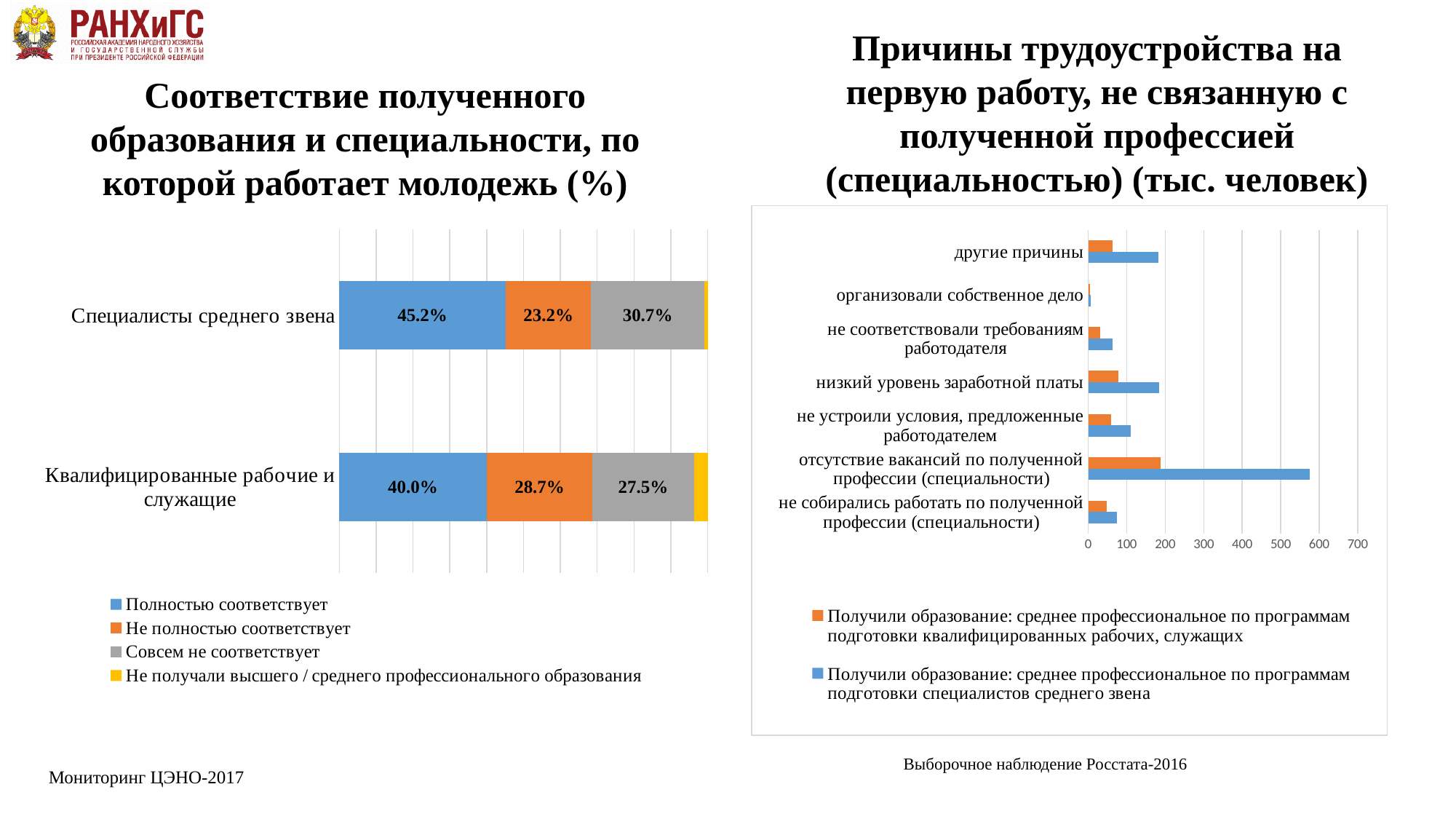
In the left chart (Соответствие полученного образования и специальности), what is the value of 'Полностью соответствует' for 'Специалисты среднего звена'? 45.2% In the right chart, which reason has the highest value for the blue series (специалисты среднего звена)? отсутствие вакансий по полученной профессии (специальности) How many reasons (categories) are listed in the right chart? 7 In the right chart, which reason has the lowest values for both series? организовали собственное дело How many series does the legend of the left chart list? 4 In the right chart (Причины трудоустройства на первую работу), is the value for 'отсутствие вакансий по полученной профессии (специальности)' for specialists of the middle level (blue series) greater or less than 500? greater How many categories are shown in the left chart? 2 In the left chart, what is the value of 'Не полностью соответствует' for 'Квалифицированные рабочие и служащие'? 28.7% In the left chart, what is the value of 'Совсем не соответствует' for 'Специалисты среднего звена'? 30.7% In the left chart, which category has the larger 'Совсем не соответствует' value? Специалисты среднего звена What kind of chart is the left chart? Stacked bar chart In the left chart, what is the difference between the 'Полностью соответствует' values for 'Специалисты среднего звена' and 'Квалифицированные рабочие и служащие'? 5.2 percentage points